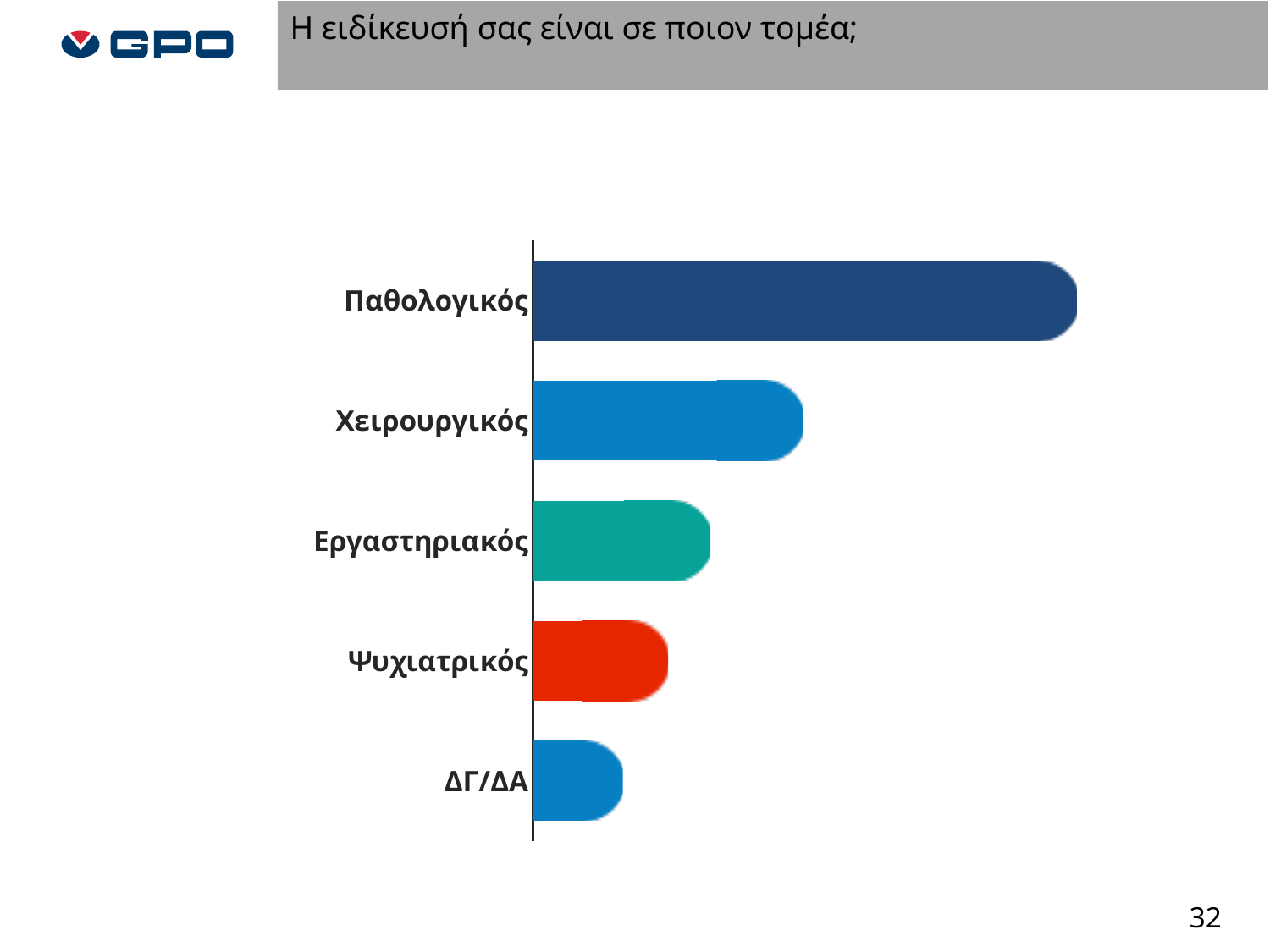
Which is larger, the value for Χειρουργικός or the value for Εργαστηριακός? Χειρουργικός Which is larger, the value for Ψυχιατρικός or the value for ΔΓ/ΔΑ? Ψυχιατρικός What kind of chart is shown on the slide? bar chart Which is larger, the value for Εργαστηριακός or the value for Ψυχιατρικός? Εργαστηριακός Which category has the longest bar? Παθολογικός How many categories are shown in the chart? 5 What colour is the bar for Ψυχιατρικός? red Are the bars in the chart horizontal or vertical? horizontal Which category has the second-longest bar? Χειρουργικός Which category has the shortest bar? ΔΓ/ΔΑ What is the title of the slide containing the chart? Η ειδίκευσή σας είναι σε ποιον τομέα;